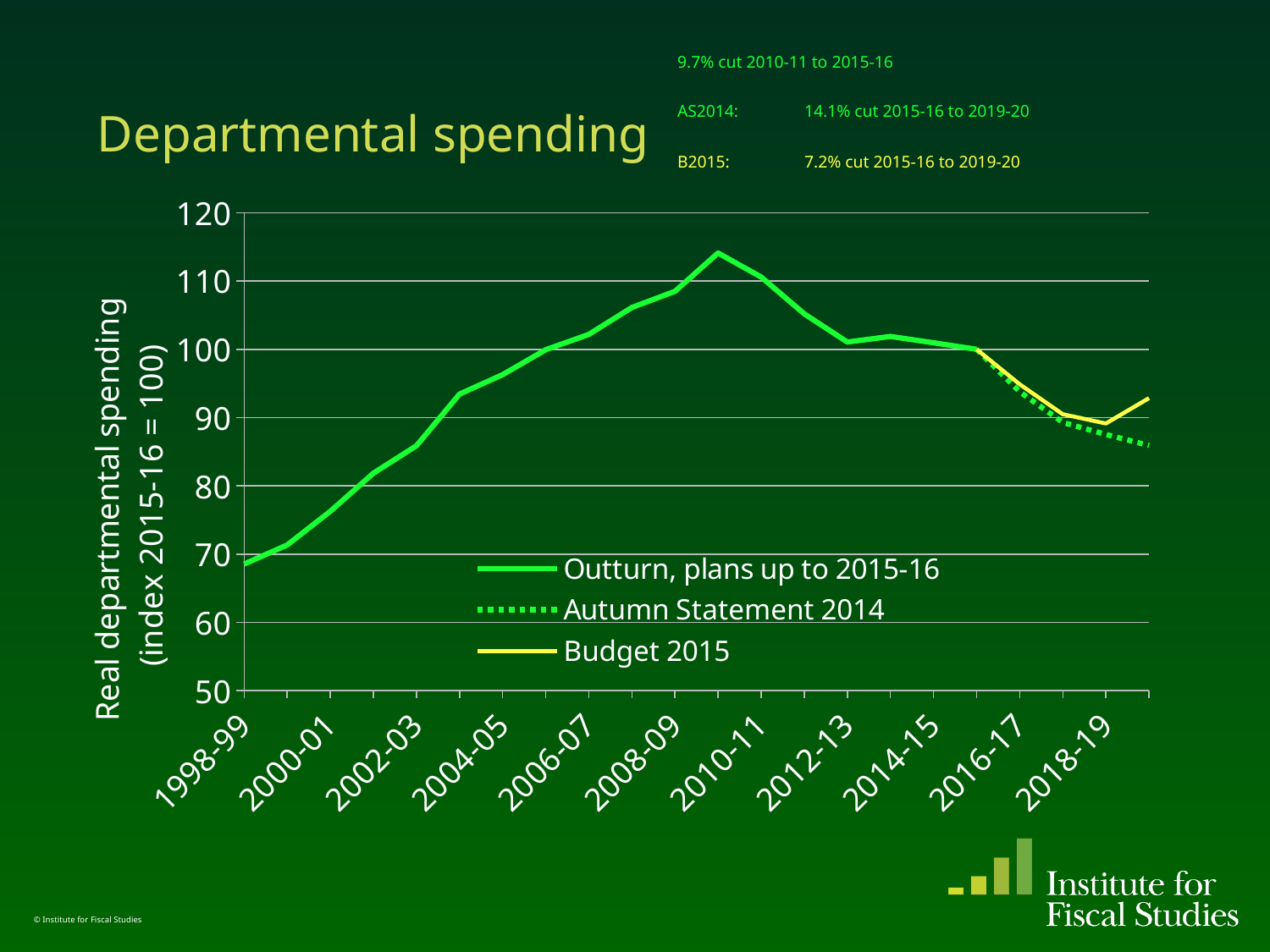
At 2019-20, which series is higher: Budget 2015 or Autumn Statement 2014? Budget 2015 Is the value for 1998-99 greater or less than 70? less What is the index value of real departmental spending in 2015-16? 100 Is the value for 2002-03 greater or less than 90? less Is the Autumn Statement 2014 value for 2019-20 greater or less than 90? less In which year does the 'Outturn, plans up to 2015-16' line reach its highest value? 2009-10 What kind of chart is shown on the slide? Line chart In which year is the 'Outturn, plans up to 2015-16' line at its lowest value? 1998-99 Does real departmental spending rise or fall between 1998-99 and 2010-11? Rise How many series does the legend list? 3 According to the annotation on the slide, what cut does B2015 imply from 2015-16 to 2019-20? 7.2% cut